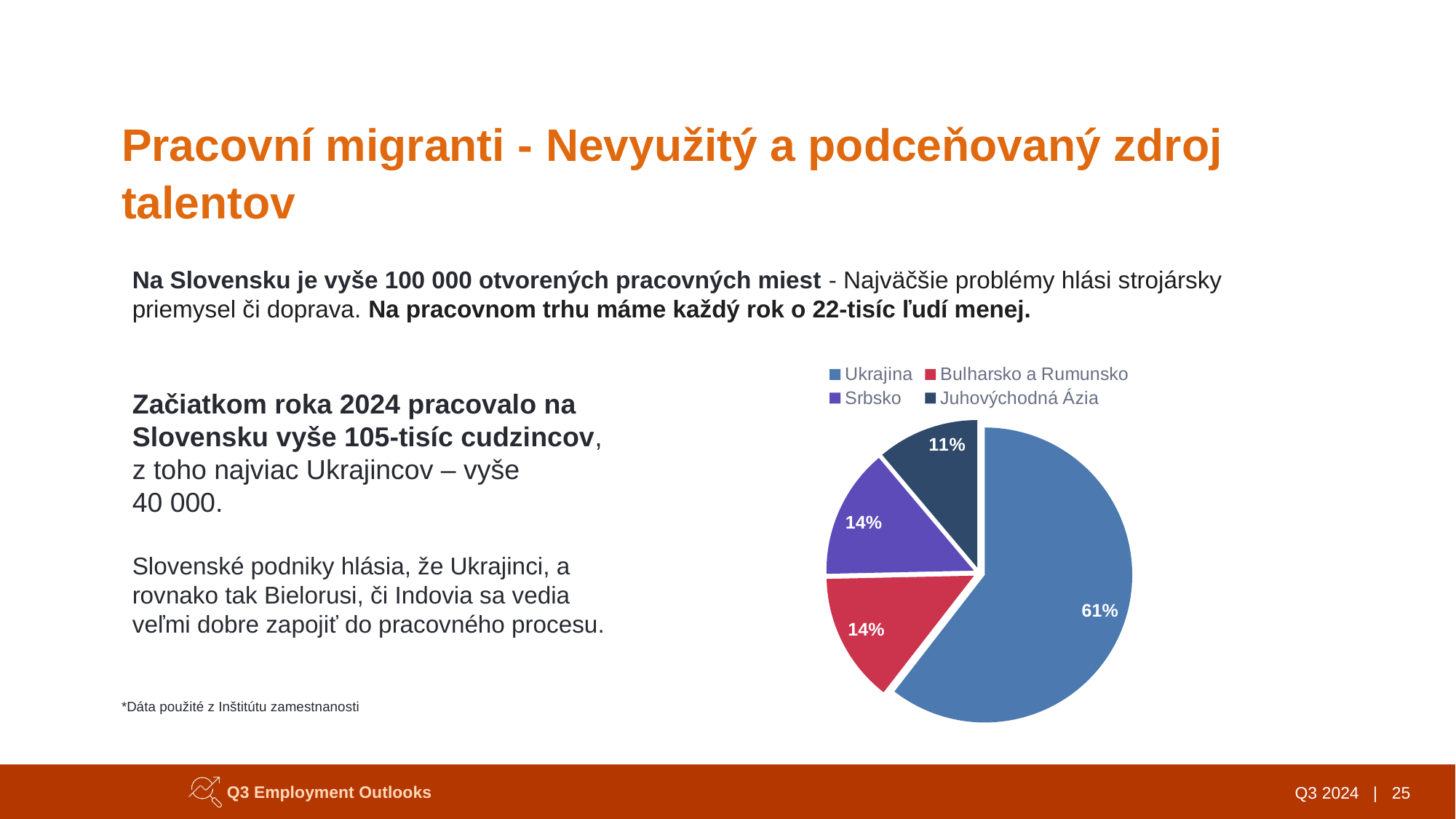
Which is larger in the pie chart, the Ukrajina slice or the Srbsko slice? Ukrajina What colour is the Ukrajina slice in the pie chart? Blue What is the difference in percentage points between the Srbsko slice and the Juhovýchodná Ázia slice? 3 How many slices does the pie chart have? 4 What is the value shown for Juhovýchodná Ázia in the pie chart? 11% What is the difference in percentage points between the Ukrajina slice and the Juhovýchodná Ázia slice? 50 What is the value shown for Bulharsko a Rumunsko in the pie chart? 14% Which category has the largest slice in the pie chart? Ukrajina What kind of chart is shown on the slide? Pie chart Which category has the smallest slice in the pie chart? Juhovýchodná Ázia What is the value shown for Srbsko in the pie chart? 14% What share of the pie chart does Ukrajina account for? 61%